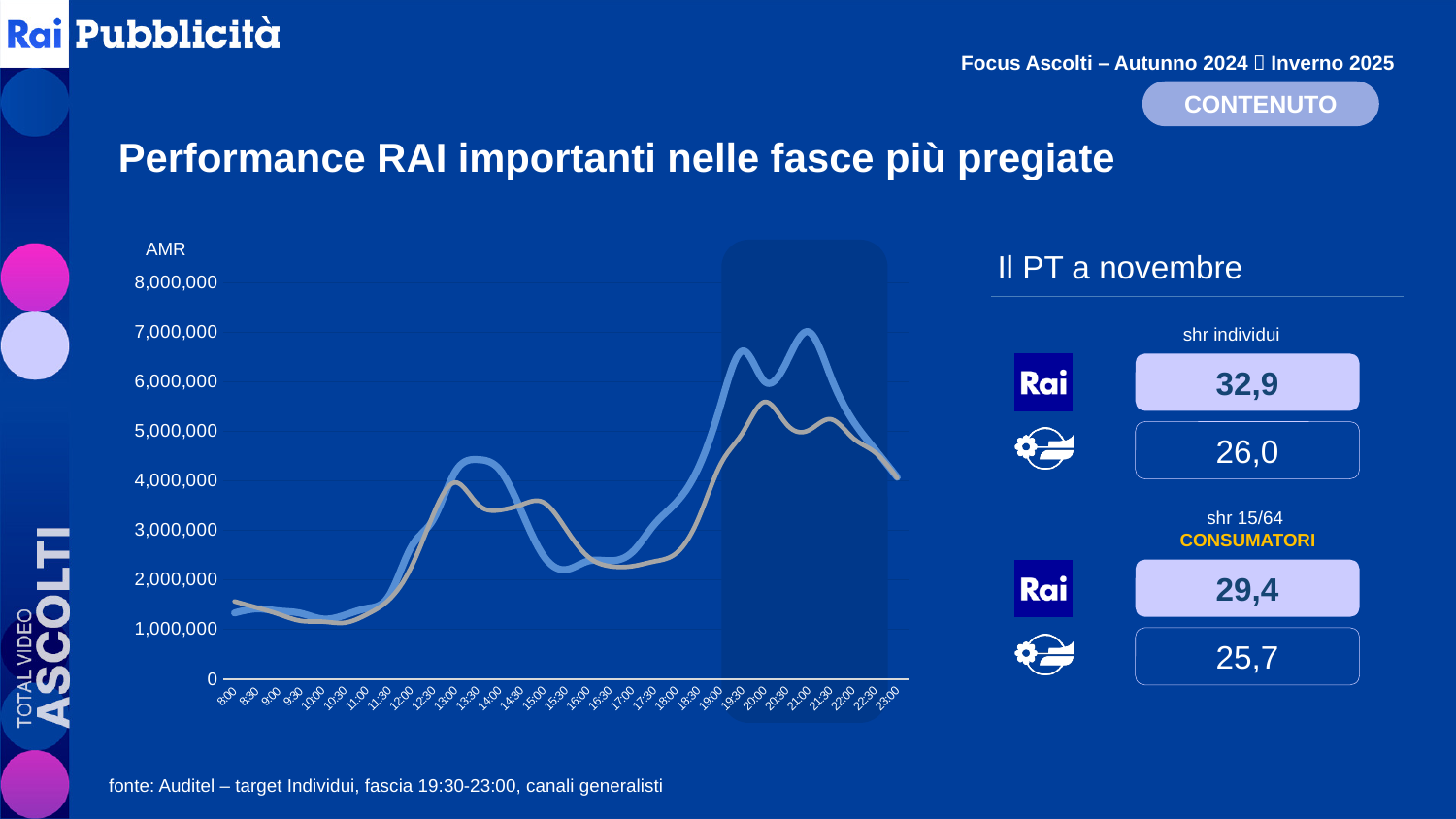
Is the value of the blue line at 8:00 greater or less than 2,000,000? less At 21:00, which line has the higher value, the blue line or the beige line? the blue line Is the value of the blue line at 15:30 greater or less than 3,000,000? less Is the value of the beige line at 20:00 greater or less than 5,000,000? greater What is the label shown above the vertical axis of the chart? AMR What kind of chart is shown on the slide? line chart What is the first time shown on the x axis of the chart? 8:00 How many lines are plotted on the chart? 2 Does the blue line rise or fall between 17:00 and 21:00? rise At what time does the blue line reach its highest value? 21:00 At what time does the beige line reach its highest value? 20:00